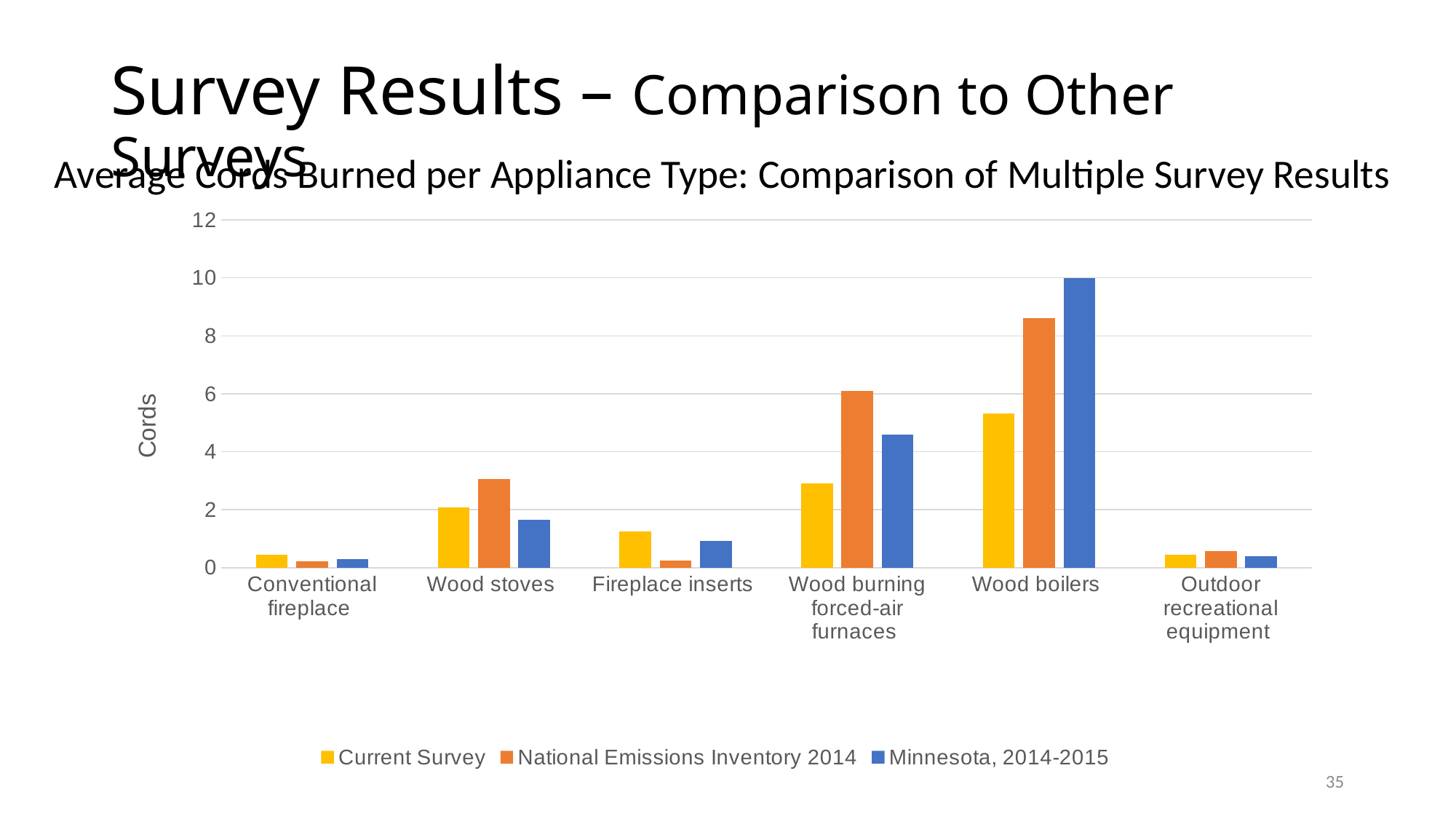
Is the Current Survey value for Wood boilers greater or less than 6? less What kind of chart is shown on the slide? bar chart For Wood burning forced-air furnaces, which series is larger: Current Survey or National Emissions Inventory 2014? National Emissions Inventory 2014 How many appliance type categories are shown on the x axis? 6 Which appliance type has the highest value for the Current Survey series? Wood boilers What is the label on the vertical axis of the chart? Cords For Wood stoves, which series is larger: National Emissions Inventory 2014 or Minnesota, 2014-2015? National Emissions Inventory 2014 Is the National Emissions Inventory 2014 value for Wood boilers greater or less than 8? greater Which appliance type has the highest value for the Minnesota, 2014-2015 series? Wood boilers Which appliance type has the highest value for the National Emissions Inventory 2014 series? Wood boilers Is the Minnesota, 2014-2015 value for Wood burning forced-air furnaces greater or less than 4? greater How many series does the legend list? 3